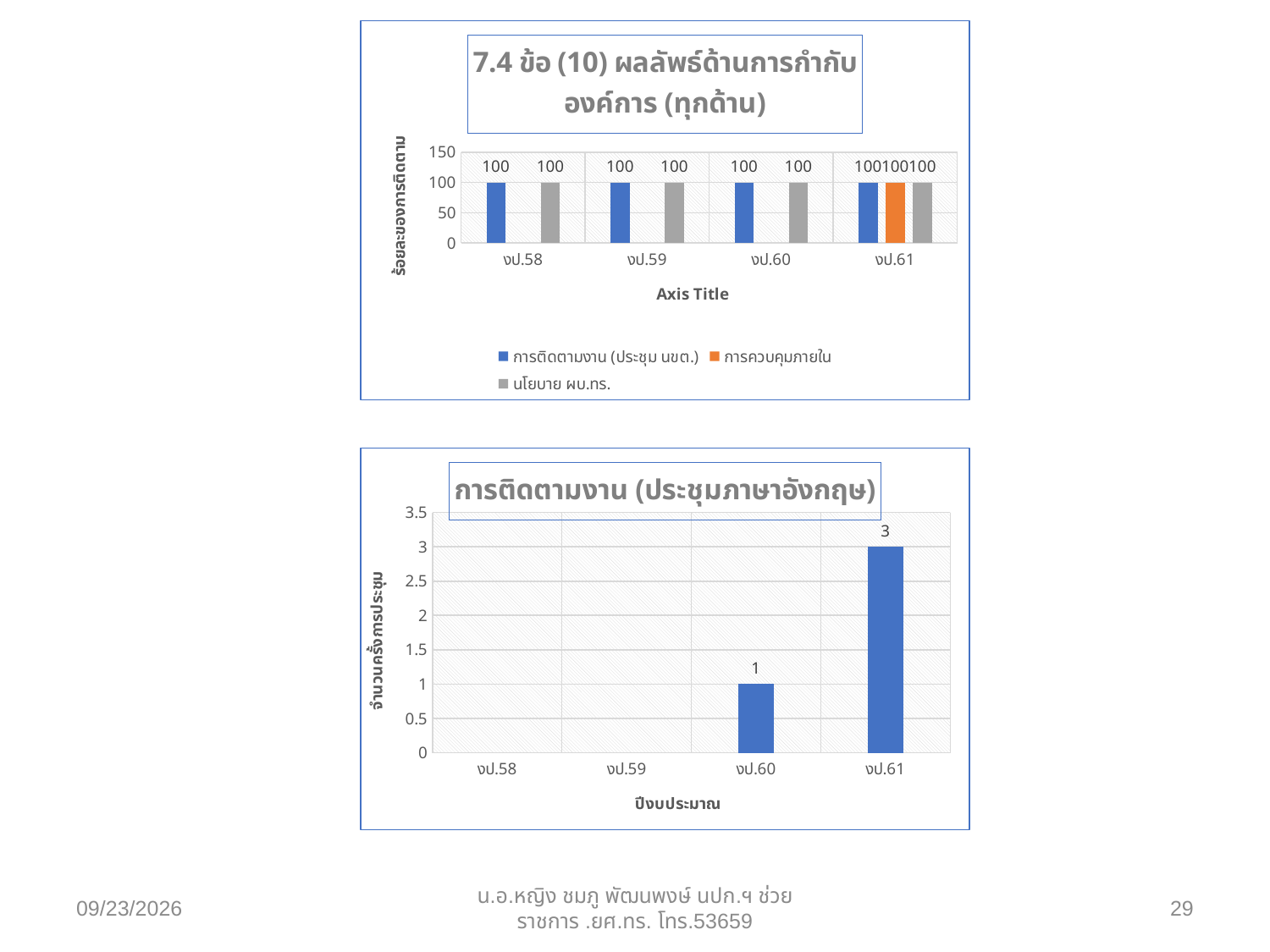
In the bottom chart (การติดตามงาน (ประชุมภาษาอังกฤษ)), how many categories are shown on the x axis? 4 In the bottom chart (การติดตามงาน (ประชุมภาษาอังกฤษ)), which is larger, the value for งป.60 or งป.61? งป.61 In the top chart (7.4 ข้อ (10) ผลลัพธ์ด้านการกำกับองค์การ (ทุกด้าน)), what is the value of การควบคุมภายใน for งป.61? 100 In the bottom chart (การติดตามงาน (ประชุมภาษาอังกฤษ)), what is the value for งป.61? 3 What is the x-axis title of the bottom chart (การติดตามงาน (ประชุมภาษาอังกฤษ))? ปีงบประมาณ In the bottom chart (การติดตามงาน (ประชุมภาษาอังกฤษ)), which category has the highest value? งป.61 In the top chart (7.4 ข้อ (10) ผลลัพธ์ด้านการกำกับองค์การ (ทุกด้าน)), which series is shown in orange? การควบคุมภายใน What kind of chart is the bottom chart (การติดตามงาน (ประชุมภาษาอังกฤษ))? Bar chart In the bottom chart (การติดตามงาน (ประชุมภาษาอังกฤษ)), what is the value for งป.60? 1 In the bottom chart (การติดตามงาน (ประชุมภาษาอังกฤษ)), what is the difference between the values for งป.61 and งป.60? 2 How many series does the legend of the top chart (7.4 ข้อ (10) ผลลัพธ์ด้านการกำกับองค์การ (ทุกด้าน)) list? 3 In the top chart (7.4 ข้อ (10) ผลลัพธ์ด้านการกำกับองค์การ (ทุกด้าน)), what is the value of การติดตามงาน (ประชุม นขต.) for งป.58? 100